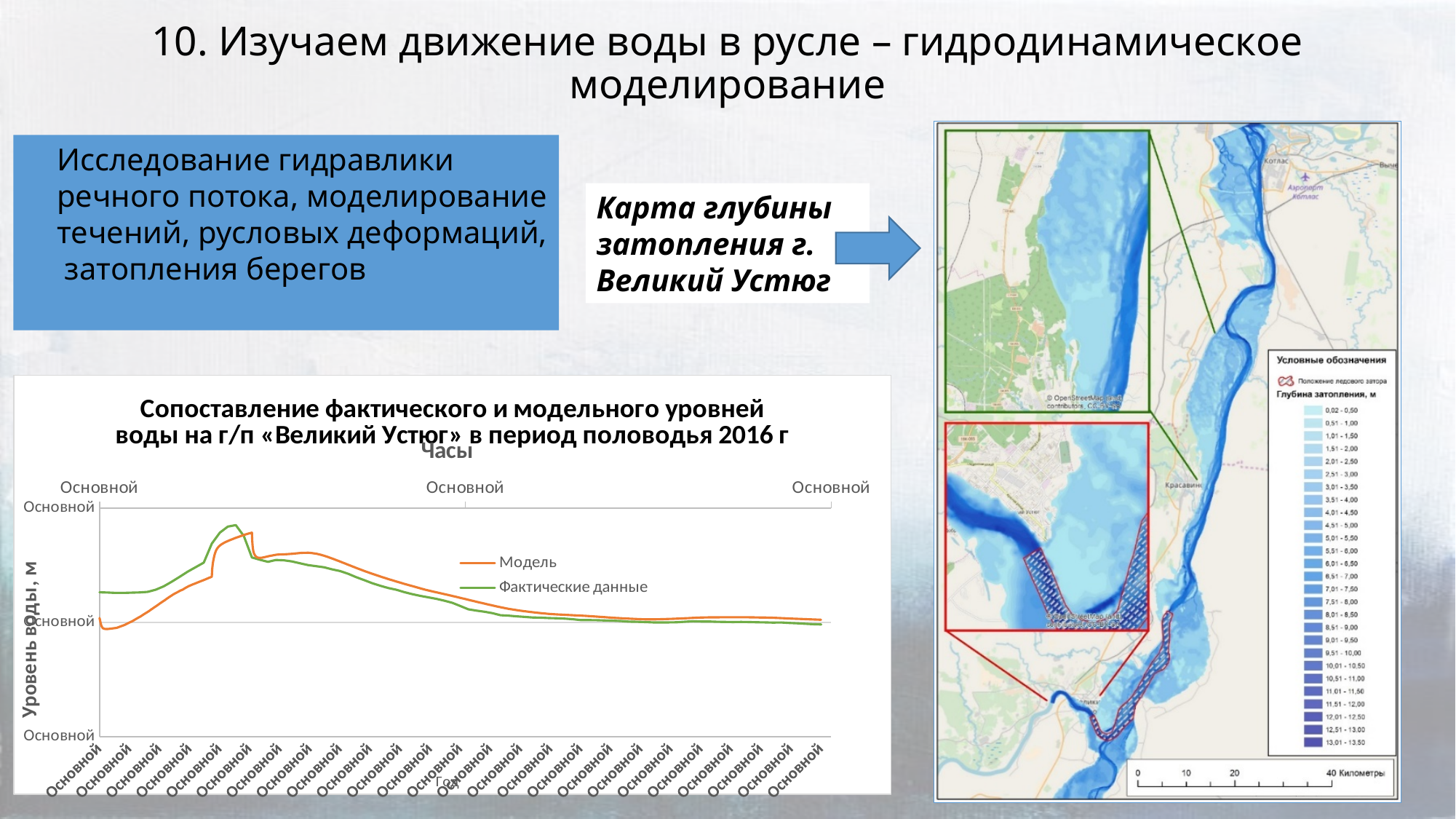
What kind of chart is shown on the slide? line chart How many series does the chart legend list? 2 At the left end of the x axis, which series has the higher value, Модель or Фактические данные? Фактические данные What is the title of the chart on the slide? Сопоставление фактического и модельного уровней воды на г/п «Великий Устюг» в период половодья 2016 г Which series is drawn in orange in the chart? Модель What is the label of the vertical axis of the chart? Уровень воды, м After reaching their peak, do the lines in the chart rise or fall toward the right end of the x axis? fall